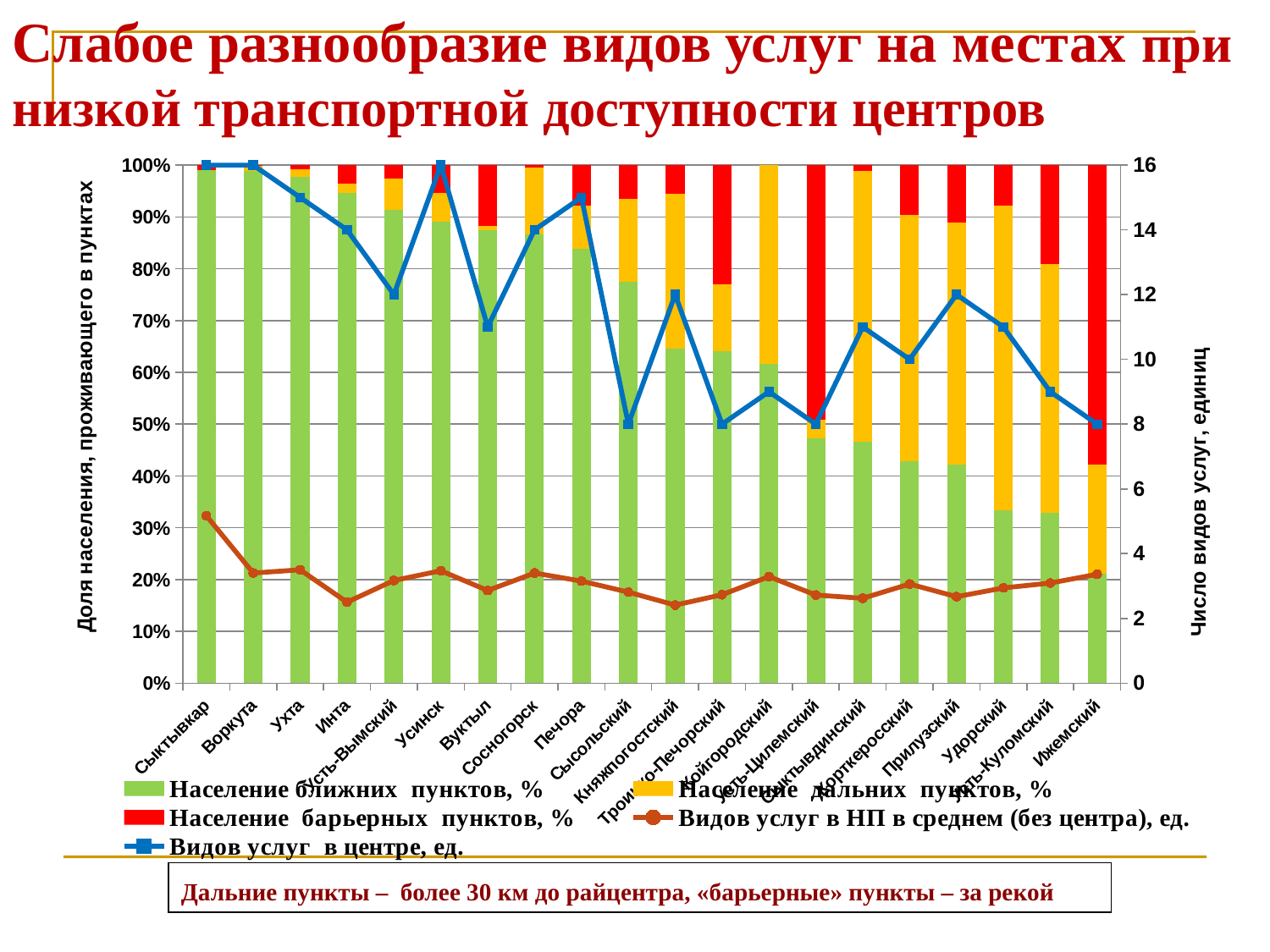
How many series does the legend list? 5 Is the value of 'Видов услуг в НП в среднем (без центра), ед.' for Сыктывкар greater or less than 4? greater Which category has the highest value of 'Видов услуг в НП в среднем (без центра), ед.'? Сыктывкар Does the line 'Видов услуг в центре, ед.' generally rise or fall from left to right along the x axis? fall Which has the larger value of 'Видов услуг в центре, ед.': Усть-Вымский or Сысольский? Усть-Вымский Is the share of 'Население ближних пунктов, %' for Ижемский greater or less than 30%? less Is the share of 'Население ближних пунктов, %' for Сыктывкар greater or less than 90%? greater What kind of chart is shown on the slide? A stacked bar chart combined with line charts How many categories (districts/cities) are shown on the x axis? 20 What is the value of 'Видов услуг в центре, ед.' for Усть-Вымский? 12 What is the value of 'Видов услуг в центре, ед.' for Сыктывкар? 16 What is the value of 'Видов услуг в центре, ед.' for Ижемский? 8